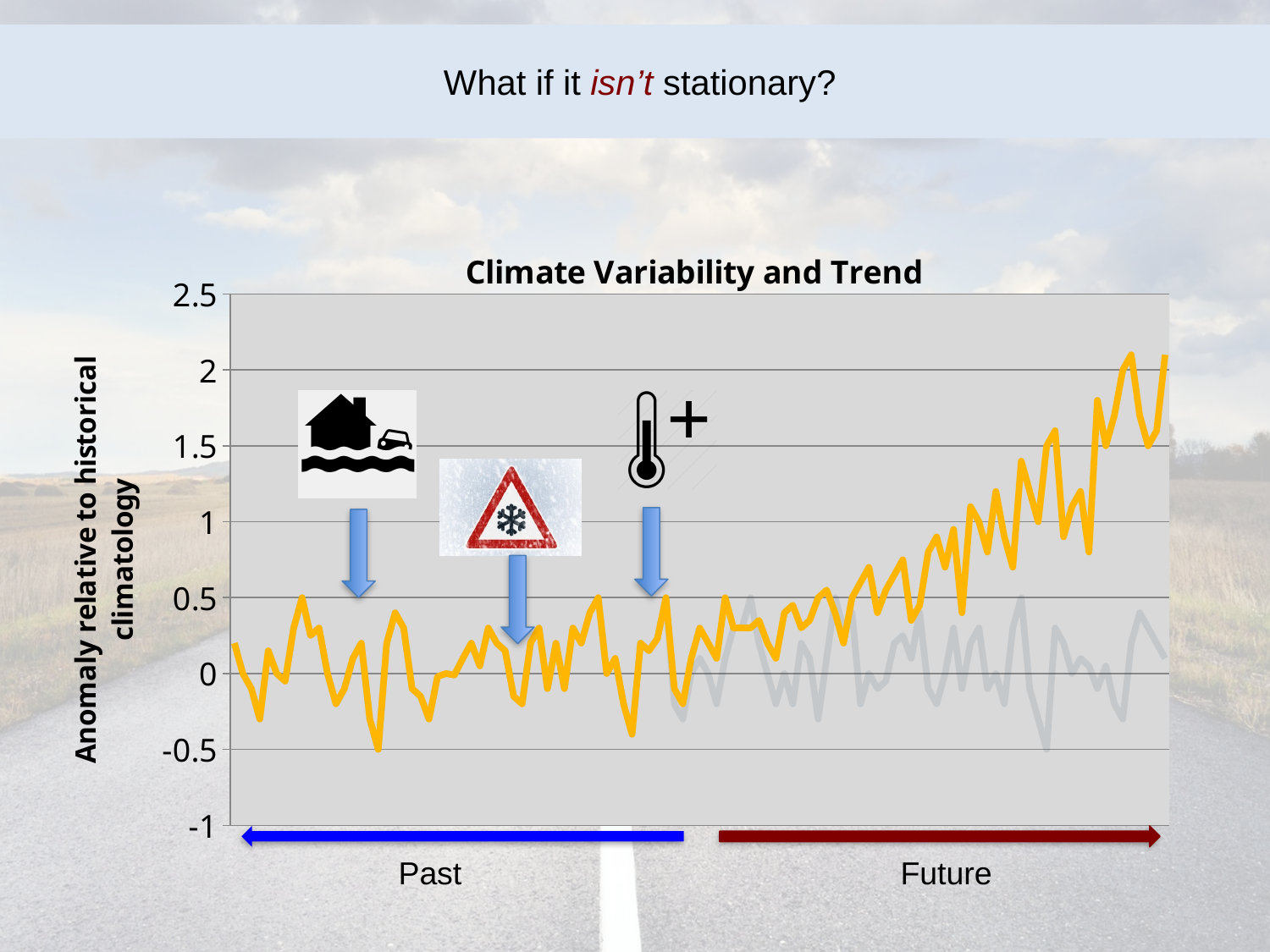
Is the value of the orange line at the far right (Future) end of the chart greater or less than 1.5? greater Is the highest value reached by the orange line in the Past section greater or less than 1? less Does the orange line rise or fall overall from the Past end to the Future end of the chart? rise What kind of chart is shown on the slide? line chart How many lines are plotted on the chart? 2 Is the lowest value reached by the orange line greater or less than -1? greater At the far right end of the chart, which line has the larger value, the orange line or the grey line? orange line What is the label of the vertical axis? Anomaly relative to historical climatology What is the title of the chart? Climate Variability and Trend What is the highest value shown on the vertical axis? 2.5